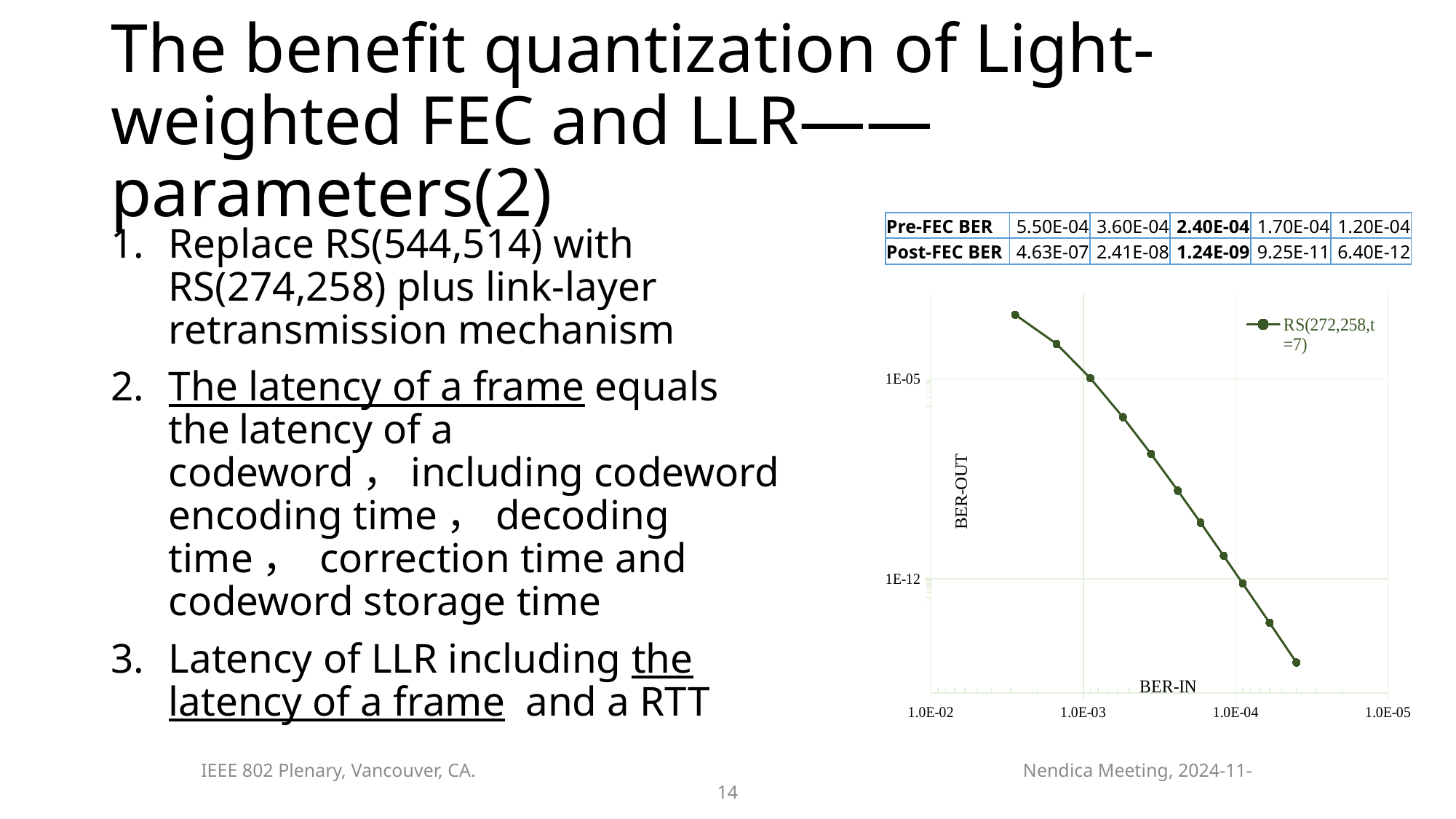
At which end of the BER-IN axis does the curve reach its lowest BER-OUT value? the right end (1.0E-05 side) Moving from left to right along the BER-IN axis, does BER-OUT rise or fall? fall What are the labels of the x axis and y axis of the chart? BER-IN and BER-OUT Is the BER-OUT value of the rightmost plotted point greater or less than 1E-12? less Which has the higher BER-OUT: the point at BER-IN 1.0E-03 or the point at BER-IN 1.0E-04? BER-IN 1.0E-03 Is the BER-OUT value of the leftmost plotted point greater or less than 1E-05? greater What kind of chart is shown on the slide? line chart What is the name of the series shown in the chart legend? RS(272,258,t=7) At which end of the BER-IN axis does the curve reach its highest BER-OUT value? the left end (1.0E-02 side) How many series does the chart legend list? 1